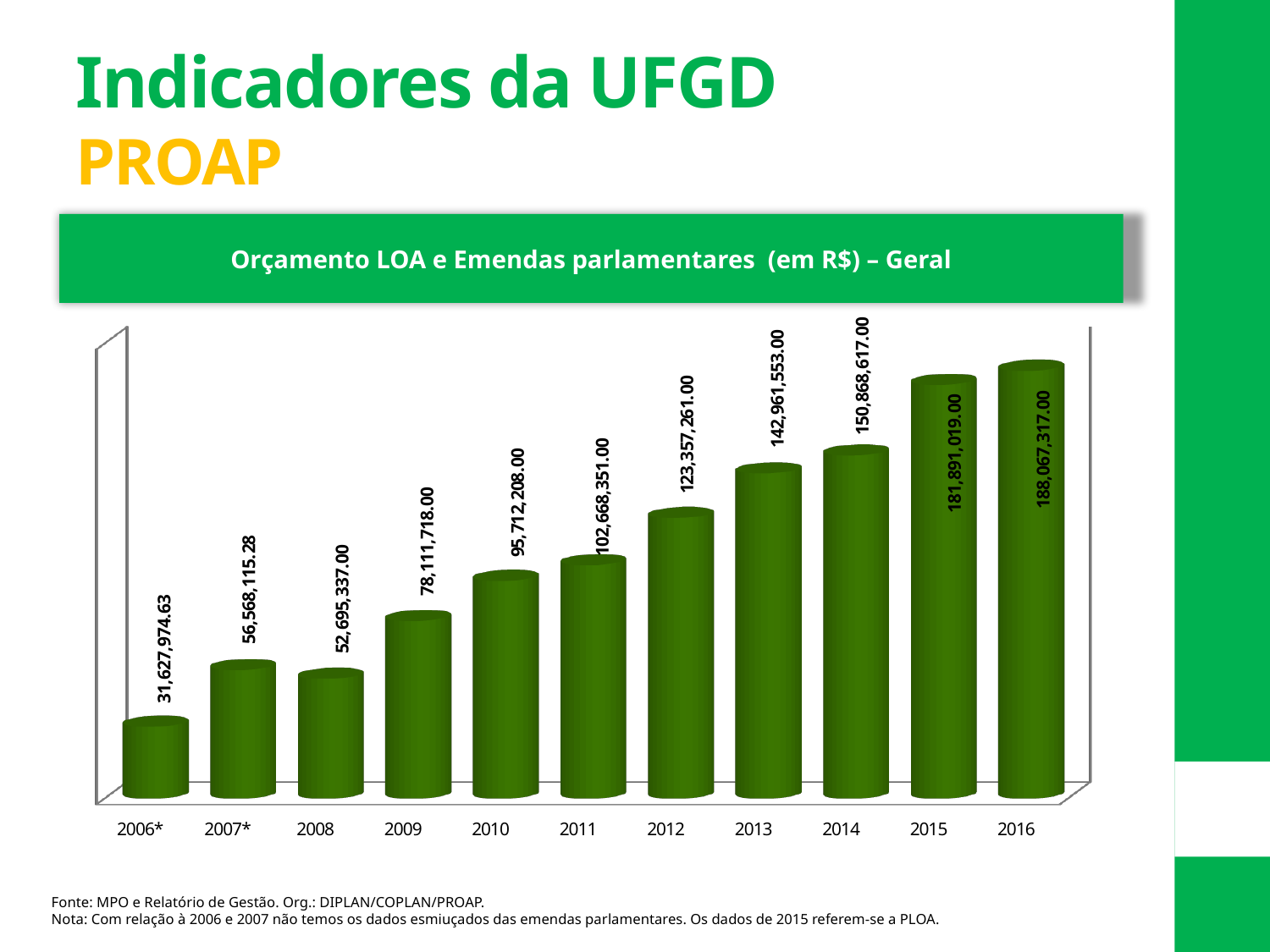
Which year has the highest value? 2016 What is the difference between the values for 2007* and 2008? 3,872,778.28 How many years are shown on the x axis? 11 What kind of chart is shown? Bar chart Which is larger, the value for 2007* or the value for 2008? 2007* Which year has the lowest value? 2006* What is the title of the chart? Orçamento LOA e Emendas parlamentares (em R$) – Geral What is the value for 2013? 142,961,553.00 What is the value for 2006*? 31,627,974.63 What is the value for 2011? 102,668,351.00 What is the difference between the values for 2016 and 2015? 6,176,298.00 What is the value for 2016? 188,067,317.00